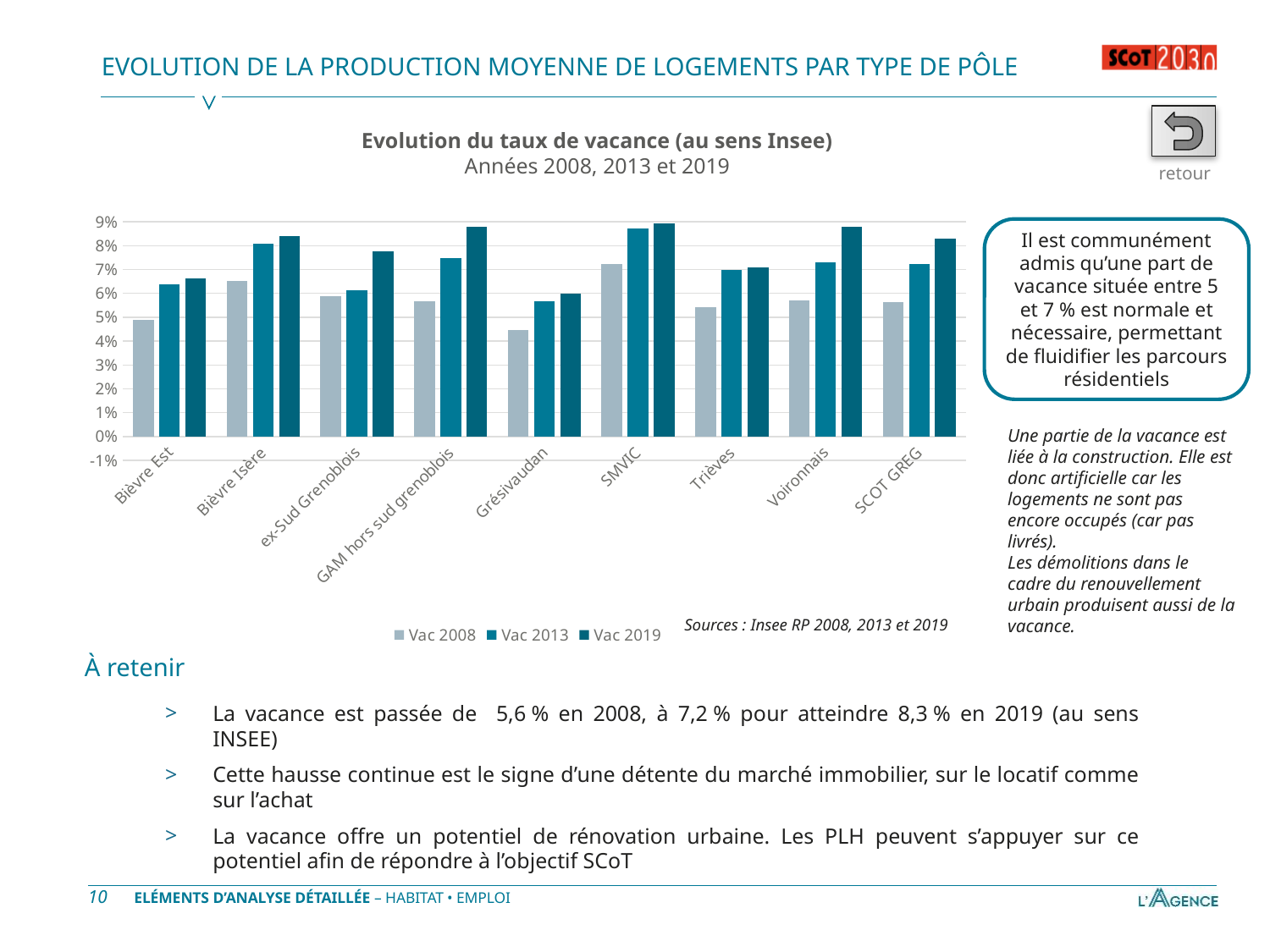
Is the Vac 2008 value for Trièves greater or less than 6%? less How many territories (categories) are shown on the x axis of the chart? 9 Which territory has the lowest Vac 2008 value? Grésivaudan Which territory has the highest Vac 2008 value? SMVIC What are the three legend entries of the chart? Vac 2008, Vac 2013, Vac 2019 Is the Vac 2008 value for Grésivaudan greater or less than 5%? less For SCOT GREG, do the values rise or fall from Vac 2008 to Vac 2019? rise What kind of chart is shown on the slide? Bar chart Is the Vac 2019 value for SMVIC greater or less than 8%? greater Which is larger, the Vac 2019 value for Bièvre Isère or the Vac 2019 value for Bièvre Est? Bièvre Isère How many series does the legend of the chart list? 3 Which territory has the lowest Vac 2019 value? Grésivaudan